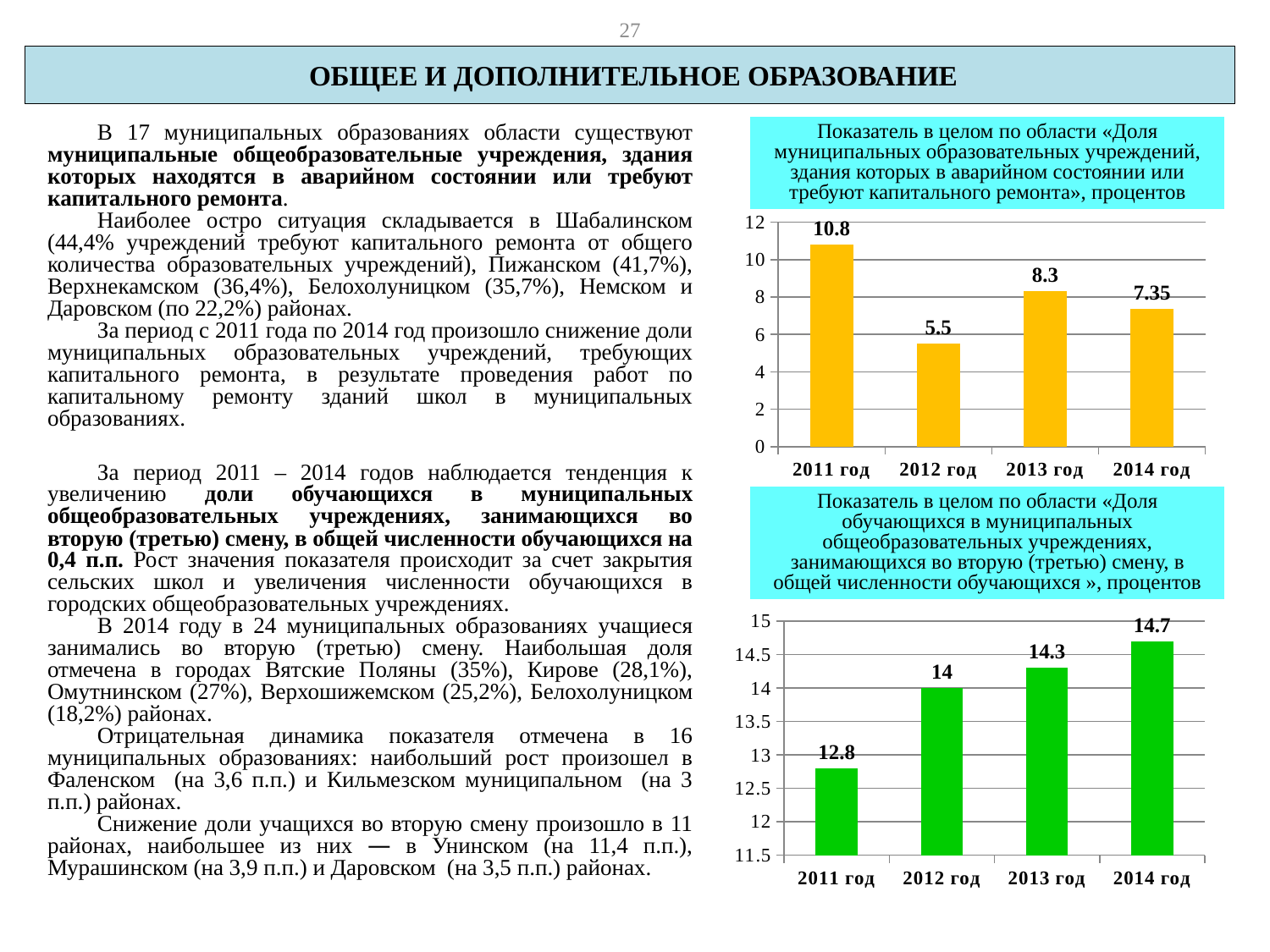
In the bottom chart, what is the value for 2012 год? 14 In the top chart, which year has the highest value? 2011 год In the top chart, what is the value for 2011 год? 10.8 What type of chart is the top chart? bar chart In the bottom chart, what is the value for 2014 год? 14.7 How many years are shown in the bottom chart? 4 In the bottom chart, what is the difference between the values for 2014 год and 2011 год? 1.9 In the top chart, what is the value for 2014 год? 7.35 In the top chart, which is larger, the value for 2013 год or 2014 год? 2013 год In the top chart, which year has the lowest value? 2012 год In the bottom chart, do the values rise or fall from 2011 год to 2014 год? rise In the top chart, what is the difference between the values for 2011 год and 2012 год? 5.3